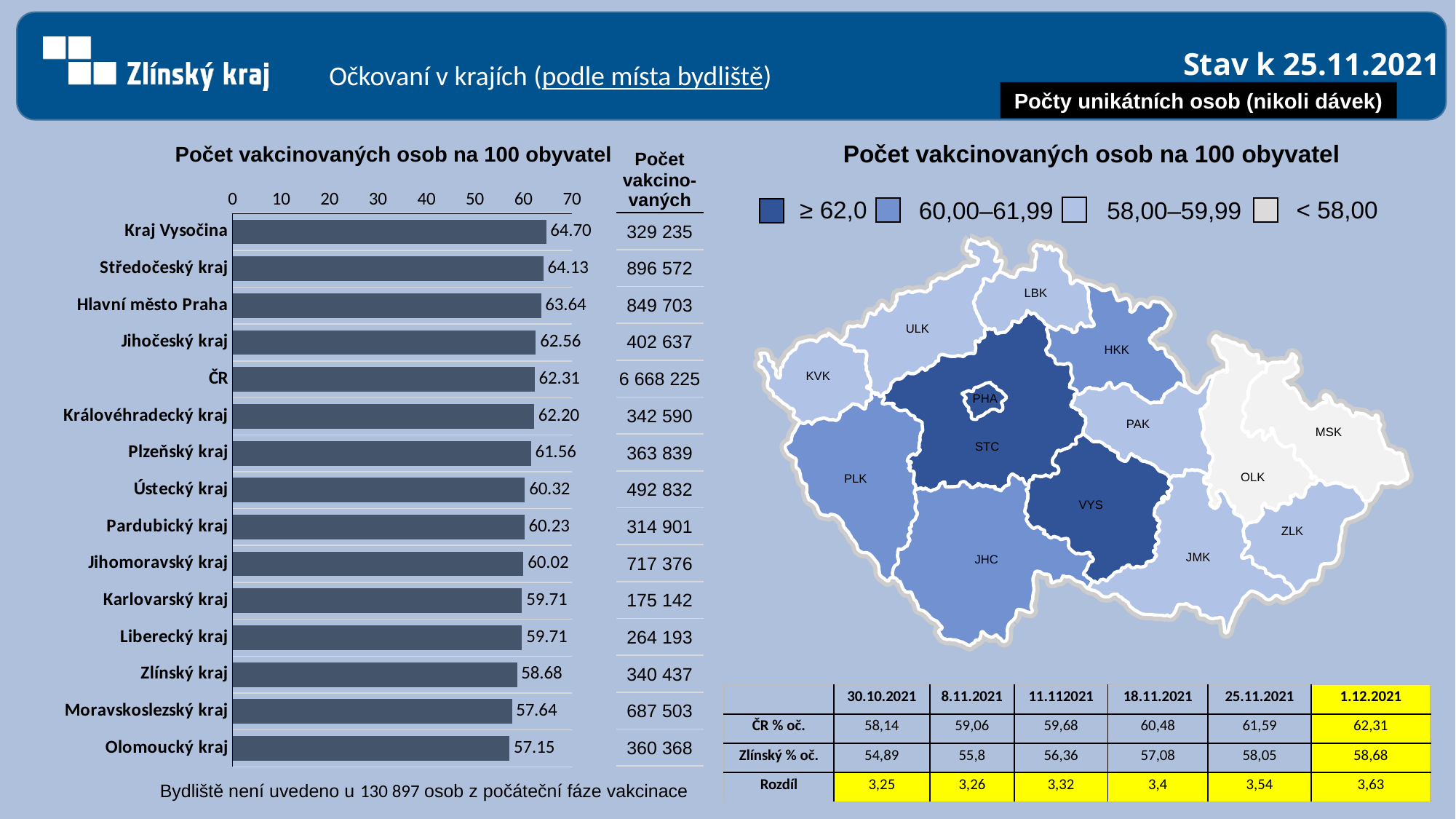
In the bar chart 'Počet vakcinovaných osob na 100 obyvatel', what is the value for ČR? 62.31 In the bar chart 'Počet vakcinovaných osob na 100 obyvatel', which category has the highest value? Kraj Vysočina In the bar chart 'Počet vakcinovaných osob na 100 obyvatel', what is the difference between the values for Kraj Vysočina and Olomoucký kraj? 7.55 What kind of chart is 'Počet vakcinovaných osob na 100 obyvatel' on the left of the slide? bar chart How many categories (bars) are shown in the bar chart 'Počet vakcinovaných osob na 100 obyvatel'? 15 In the bar chart 'Počet vakcinovaných osob na 100 obyvatel', is the value for Moravskoslezský kraj greater or less than 60? less In the bar chart 'Počet vakcinovaných osob na 100 obyvatel', which category has the lowest value? Olomoucký kraj In the bar chart 'Počet vakcinovaných osob na 100 obyvatel', what is the value for Zlínský kraj? 58.68 In the bar chart 'Počet vakcinovaných osob na 100 obyvatel', which is larger, the value for Jihočeský kraj or the value for Plzeňský kraj? Jihočeský kraj What is the highest tick value shown on the horizontal axis of the bar chart 'Počet vakcinovaných osob na 100 obyvatel'? 70 In the bar chart 'Počet vakcinovaných osob na 100 obyvatel', what is the value for Kraj Vysočina? 64.70 In the bar chart 'Počet vakcinovaných osob na 100 obyvatel', what is the difference between the values for ČR and Zlínský kraj? 3.63